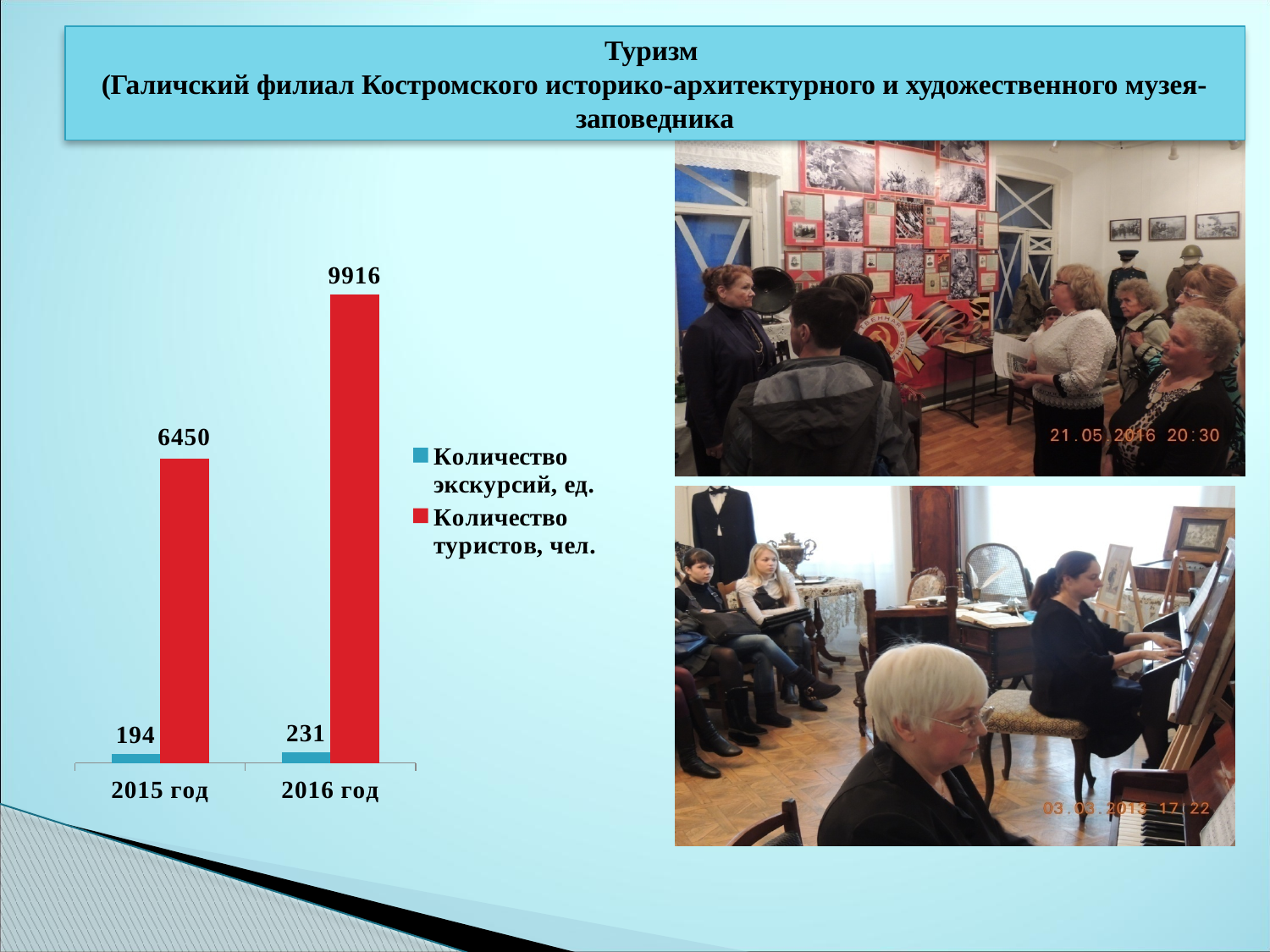
How many years are shown on the x axis of the chart? 2 How many series does the legend list? 2 What kind of chart is shown on the slide? Bar chart What was the number of tourists (Количество туристов, чел.) in 2016 год? 9916 Do the values for both series rise or fall from 2015 год to 2016 год? Rise What was the number of excursions (Количество экскурсий, ед.) in 2016 год? 231 What was the number of tourists (Количество туристов, чел.) in 2015 год? 6450 Which year had the higher number of tourists? 2016 год By how much did the number of excursions increase from 2015 год to 2016 год? 37 What was the number of excursions (Количество экскурсий, ед.) in 2015 год? 194 Which is larger: the number of excursions in 2015 год or in 2016 год? 2016 год By how much did the number of tourists increase from 2015 год to 2016 год? 3466